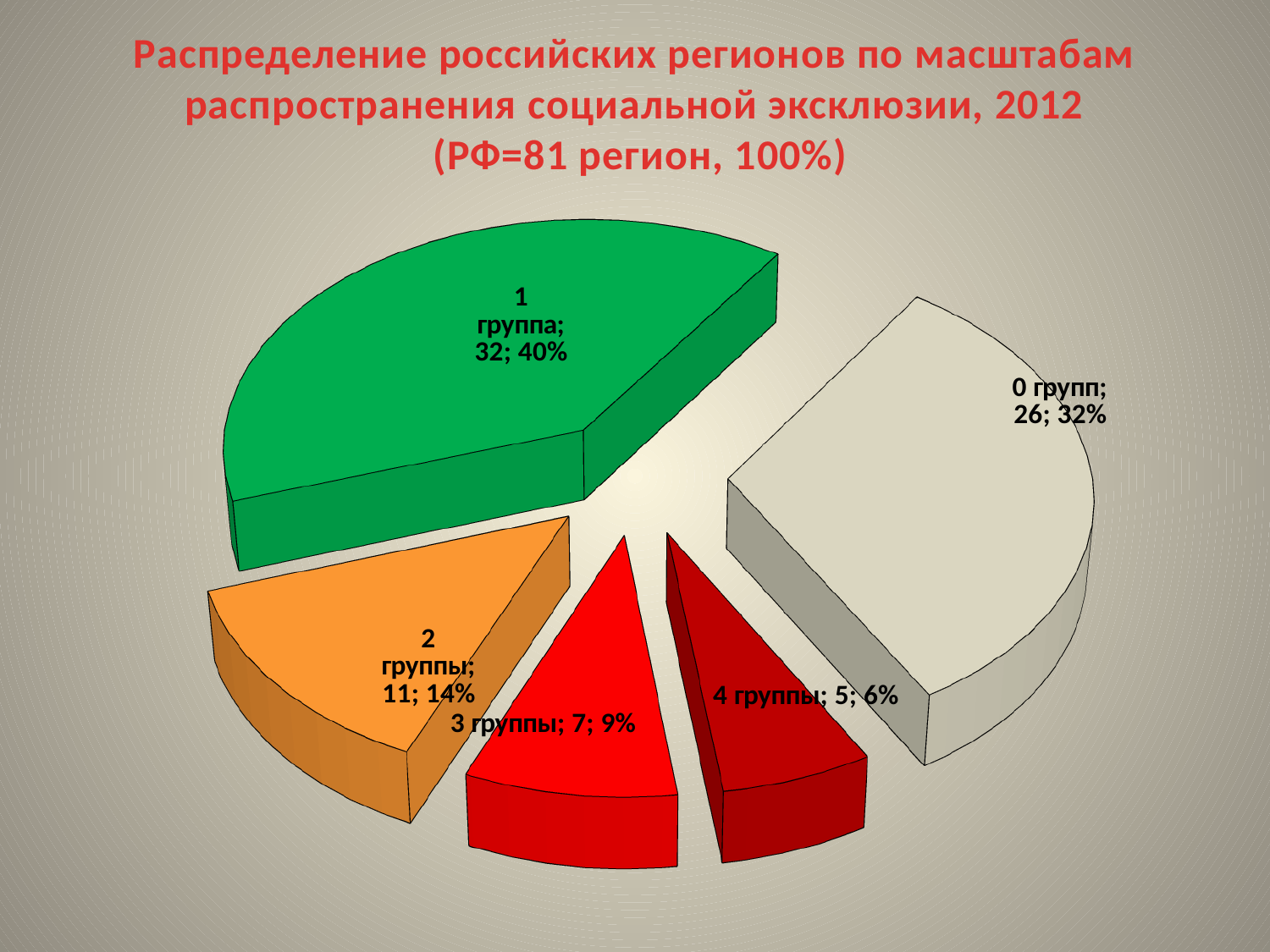
What colour is the "1 группа" slice? green How many slices does the pie chart have? 5 What percentage share does the "3 группы" slice have? 9% Which slice has more regions, "2 группы" or "3 группы"? 2 группы How many regions are in the "4 группы" slice? 5 How many regions are in the "2 группы" slice? 11 What is the difference in the number of regions between "1 группа" and "0 групп"? 6 How many regions are in the "1 группа" slice? 32 Which slice has the smallest share of the pie? 4 группы Which slice has the largest share of the pie? 1 группа What percentage share does the "0 групп" slice have? 32% What kind of chart is shown on the slide? pie chart